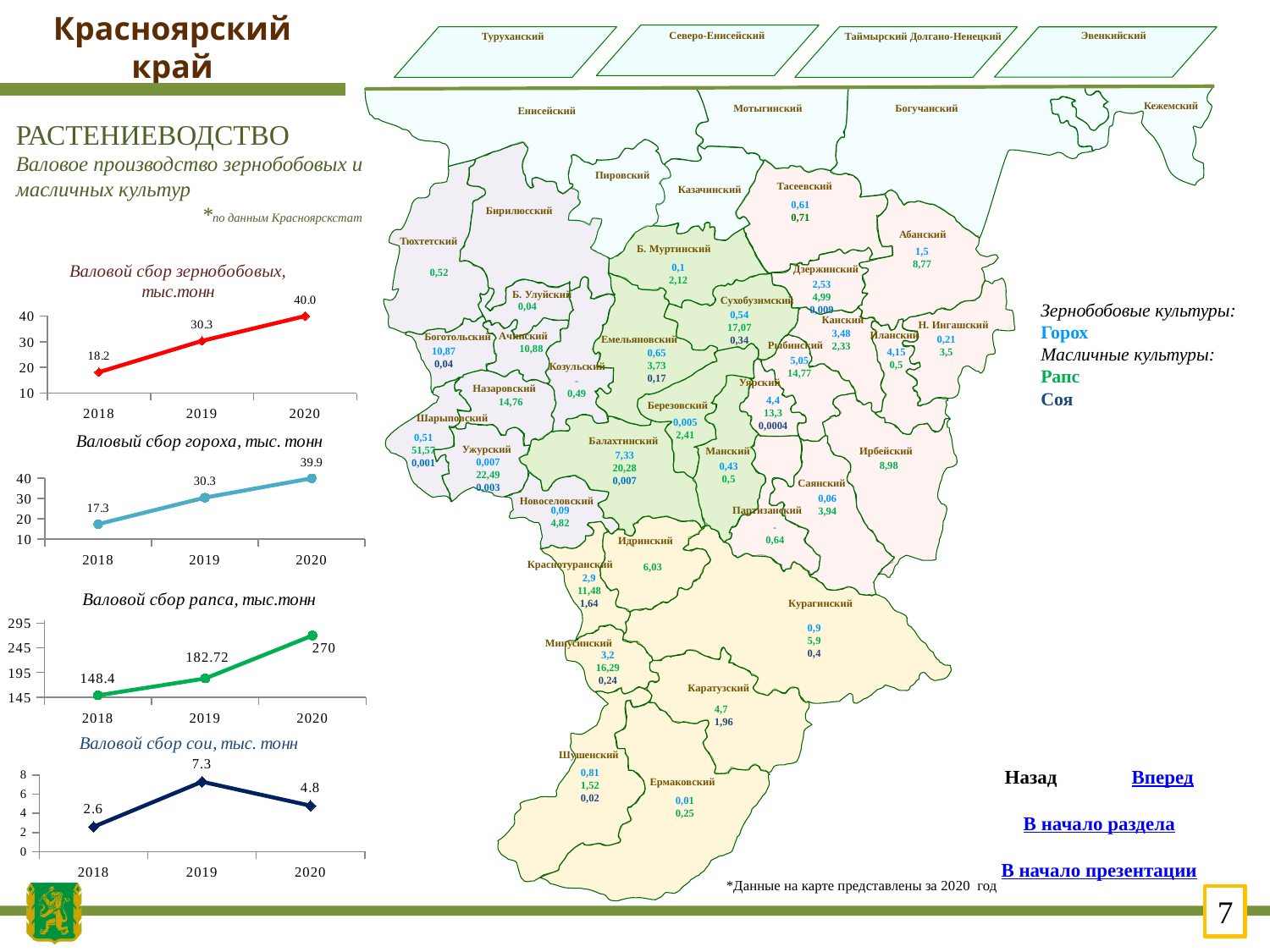
In the chart 'Валовой сбор сои, тыс. тонн', what is the value for 2019? 7.3 In the chart 'Валовой сбор сои, тыс. тонн', which year has the highest value? 2019 In the chart 'Валовый сбор гороха, тыс. тонн', what is the value for 2019? 30.3 In the chart 'Валовый сбор гороха, тыс. тонн', which year has the lowest value? 2018 In the chart 'Валовой сбор зернобобовых, тыс.тонн', do the values rise or fall from 2018 to 2020? rise In the chart 'Валовой сбор рапса, тыс.тонн', what is the value for 2019? 182.72 In the chart 'Валовой сбор сои, тыс. тонн', what is the difference between the 2019 and 2020 values? 2.5 In the chart 'Валовой сбор зернобобовых, тыс.тонн', what is the value for 2018? 18.2 What kind of chart is 'Валовый сбор гороха, тыс. тонн'? line chart How many years are plotted in the chart 'Валовой сбор рапса, тыс.тонн'? 3 In the chart 'Валовой сбор рапса, тыс.тонн', which year has the highest value? 2020 In the chart 'Валовой сбор зернобобовых, тыс.тонн', what is the value for 2020? 40.0